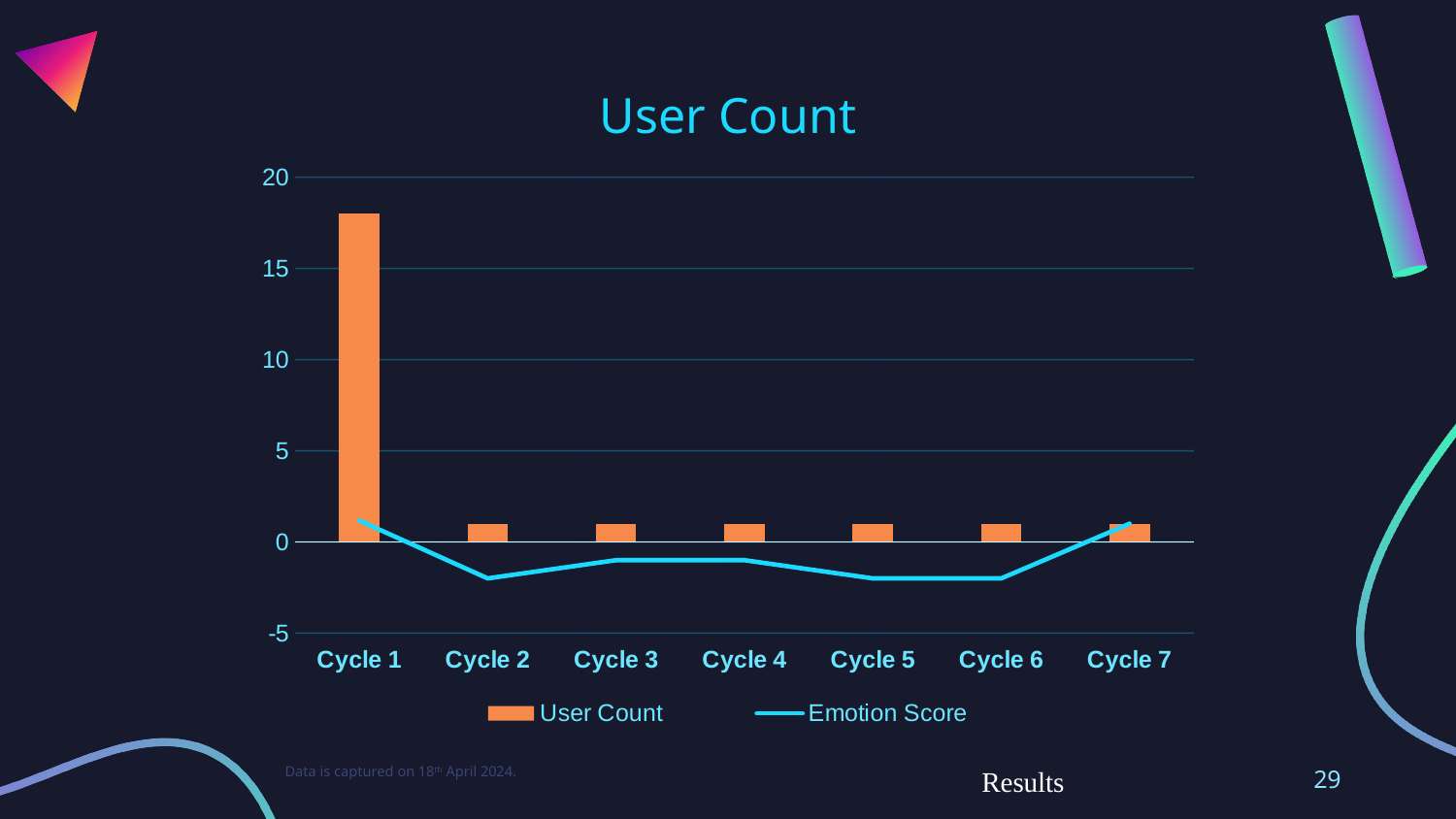
Does the Emotion Score rise or fall from Cycle 1 to Cycle 2? fall Is the Emotion Score for Cycle 5 greater or less than 0? less What is the title of the chart? User Count How many series does the legend list? 2 What kind of chart is shown on the slide? A bar chart combined with a line chart Is the Emotion Score for Cycle 2 greater or less than 0? less Which cycle has the highest User Count? Cycle 1 How many cycles are shown on the x axis? 7 Which has a larger User Count, Cycle 1 or Cycle 6? Cycle 1 Is the User Count for Cycle 1 greater or less than 15? greater Does the Emotion Score rise or fall from Cycle 6 to Cycle 7? rise